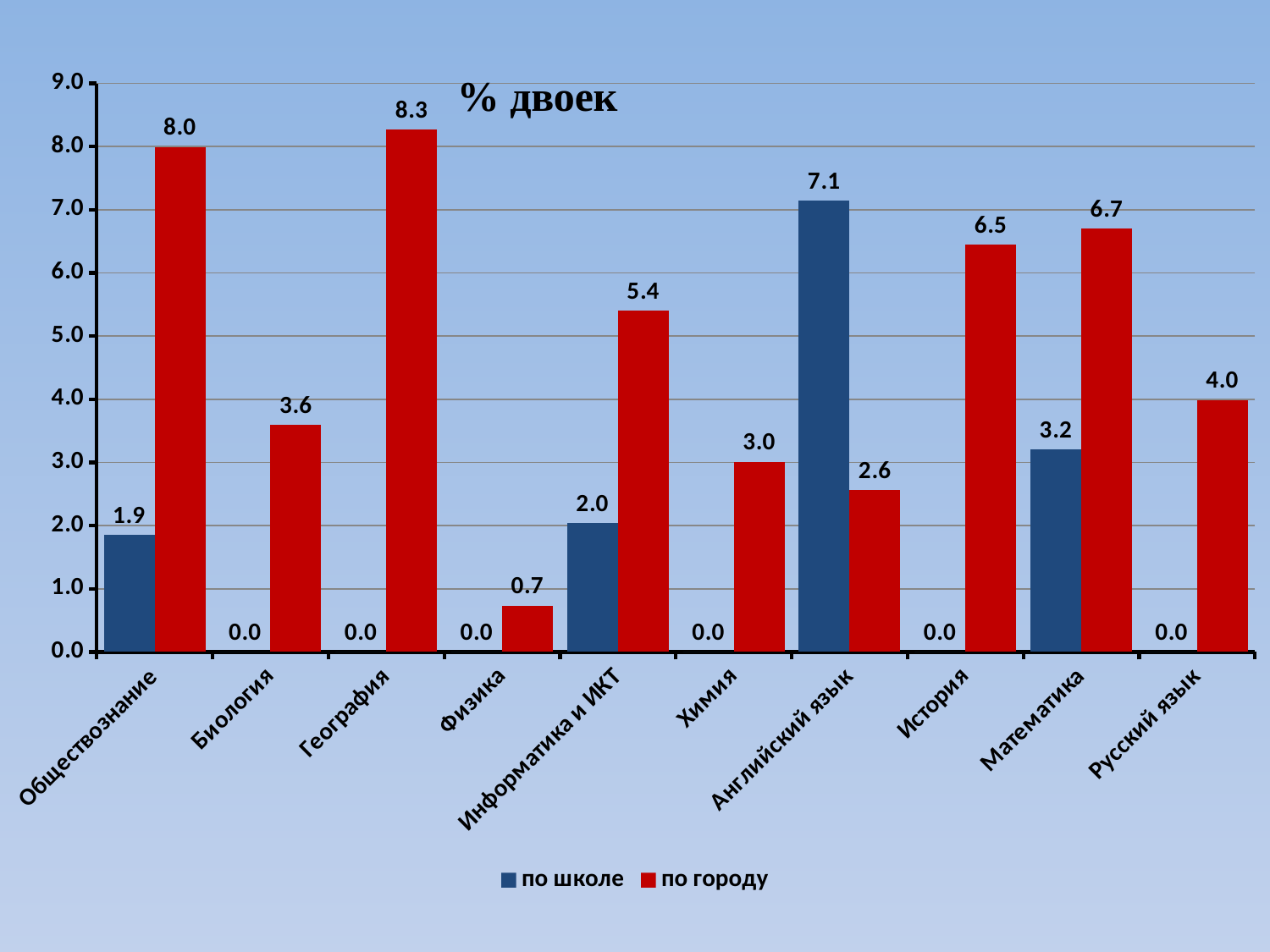
Which is larger for Английский язык: "по школе" or "по городу"? по школе How many categories are shown on the x axis? 10 What is the title of the chart? % двоек What is the value for "по городу" for Обществознание? 8.0 What is the value for "по школе" for Английский язык? 7.1 What kind of chart is shown on the slide? bar chart Which category has the highest "по школе" value? Английский язык How many series does the legend list? 2 What is the value for "по городу" for Физика? 0.7 Is the "по городу" value for Информатика и ИКТ greater or less than 5.0? greater What is the difference between the "по городу" and "по школе" values for Математика? 3.5 Which category has the highest "по городу" value? География